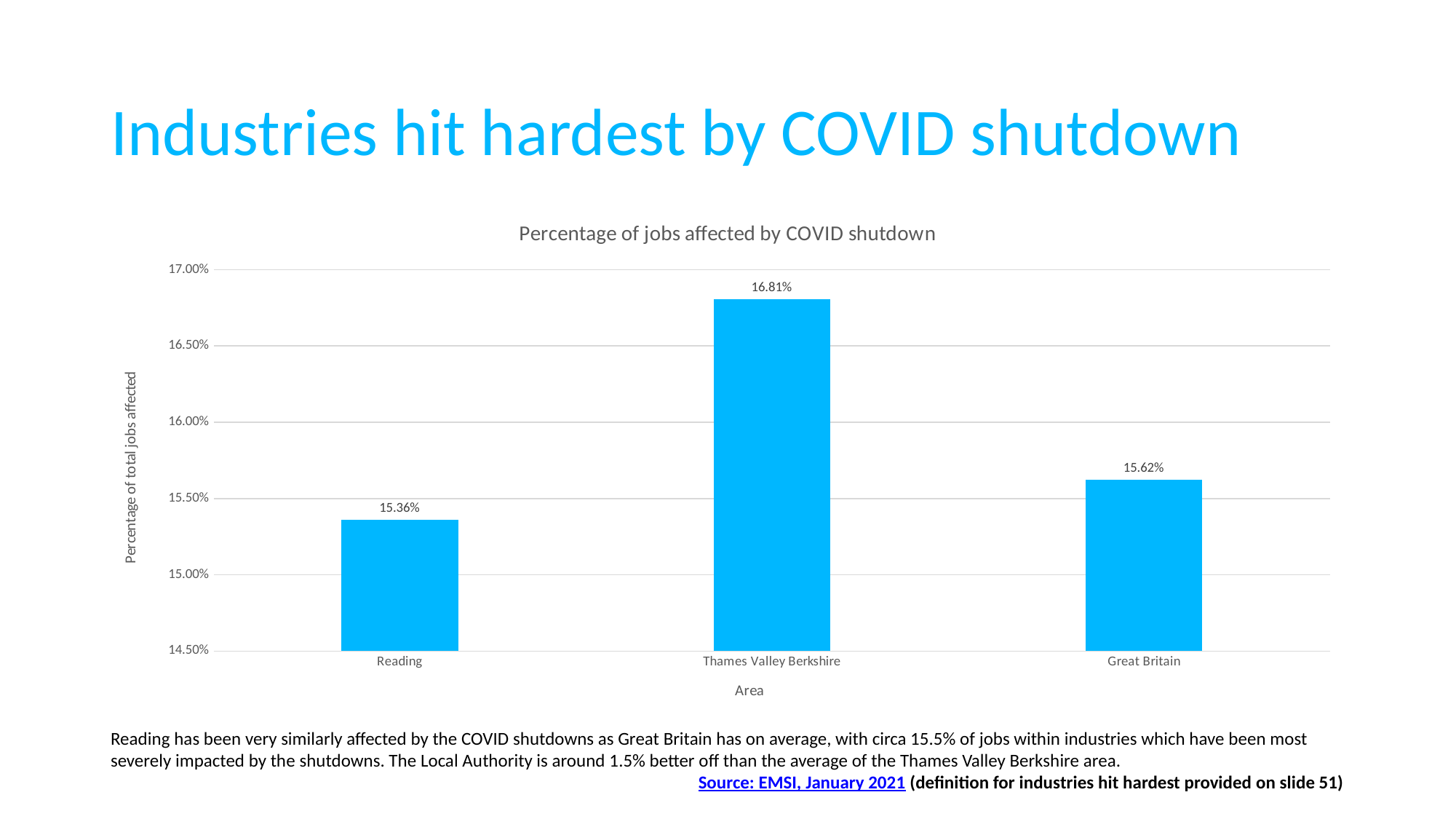
Which area has the lowest percentage of jobs affected by COVID shutdown? Reading What is the title of the chart? Percentage of jobs affected by COVID shutdown What is the difference in percentage points between Thames Valley Berkshire and Reading? 1.45% Is the value for Thames Valley Berkshire greater or less than 16.50%? greater What is the percentage of jobs affected by COVID shutdown for Thames Valley Berkshire? 16.81% Which has a higher percentage of jobs affected, Reading or Great Britain? Great Britain What is the difference in percentage points between Great Britain and Reading? 0.26% What is the percentage of jobs affected by COVID shutdown for Reading? 15.36% Which area has the highest percentage of jobs affected by COVID shutdown? Thames Valley Berkshire What is the percentage of jobs affected by COVID shutdown for Great Britain? 15.62% What type of chart is shown on the slide? Bar chart How many areas are shown on the chart? 3